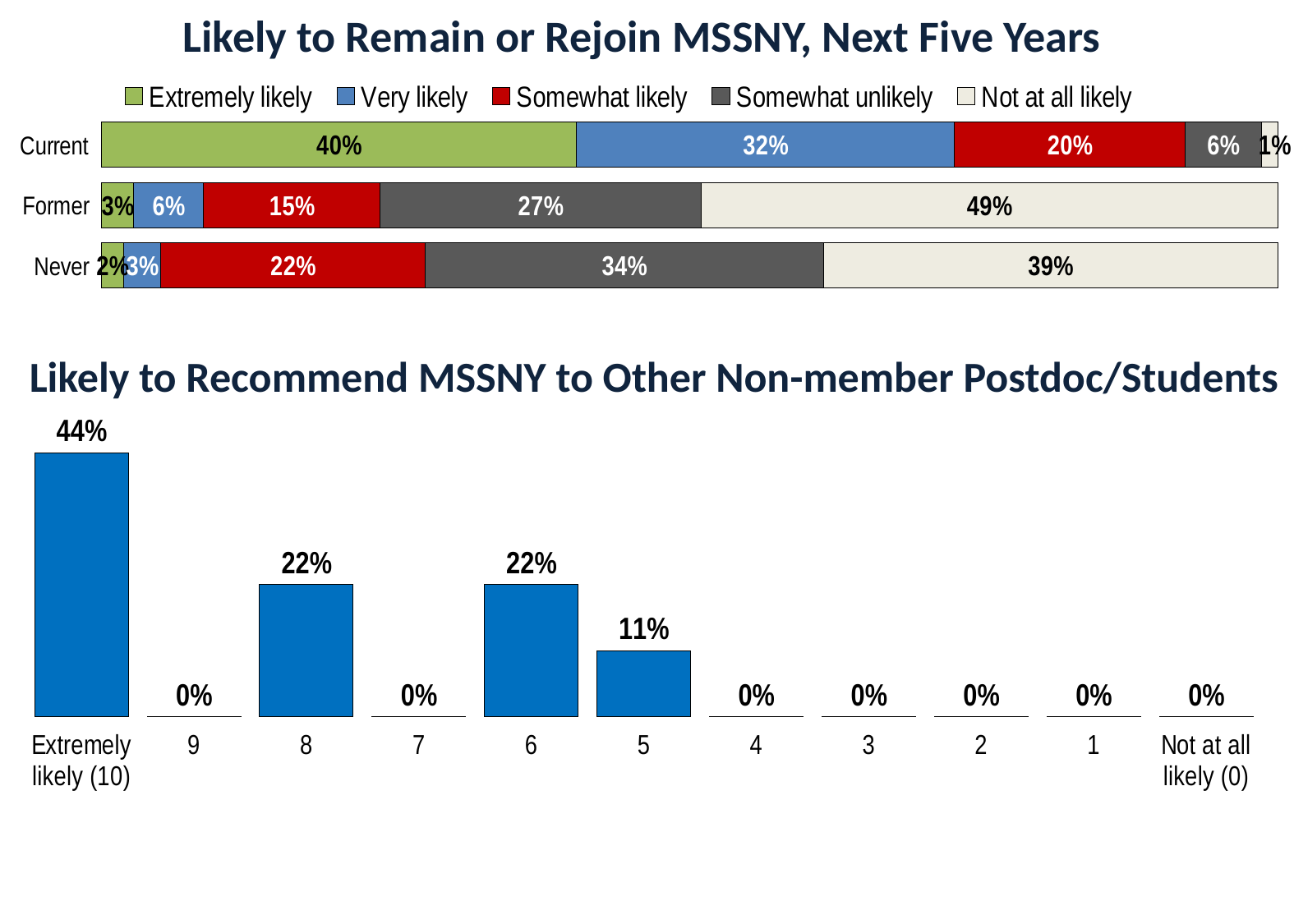
In the 'Likely to Recommend MSSNY to Other Non-member Postdoc/Students' chart, how many categories are shown on the x axis? 11 In the 'Likely to Recommend MSSNY to Other Non-member Postdoc/Students' chart, what percentage chose Extremely likely (10)? 44% In the 'Likely to Remain or Rejoin MSSNY, Next Five Years' chart, what percentage of Current members are Extremely likely to remain? 40% In the 'Likely to Recommend MSSNY to Other Non-member Postdoc/Students' chart, which category has the highest value? Extremely likely (10) In the 'Likely to Remain or Rejoin MSSNY, Next Five Years' chart, what percentage of the Never group are Somewhat unlikely? 34% What kind of chart is the 'Likely to Recommend MSSNY to Other Non-member Postdoc/Students' chart? Bar chart In the 'Likely to Recommend MSSNY to Other Non-member Postdoc/Students' chart, what percentage chose 5? 11% In the 'Likely to Remain or Rejoin MSSNY, Next Five Years' chart, which is larger: the Very likely percentage for Current or for Former? Current In the 'Likely to Remain or Rejoin MSSNY, Next Five Years' chart, what is the difference between the Not at all likely percentages for Former and Never? 10% In the 'Likely to Remain or Rejoin MSSNY, Next Five Years' chart, how many series does the legend list? 5 In the 'Likely to Remain or Rejoin MSSNY, Next Five Years' chart, what percentage of Former members are Not at all likely to rejoin? 49% In the 'Likely to Remain or Rejoin MSSNY, Next Five Years' chart, which group has the highest Somewhat likely percentage? Never